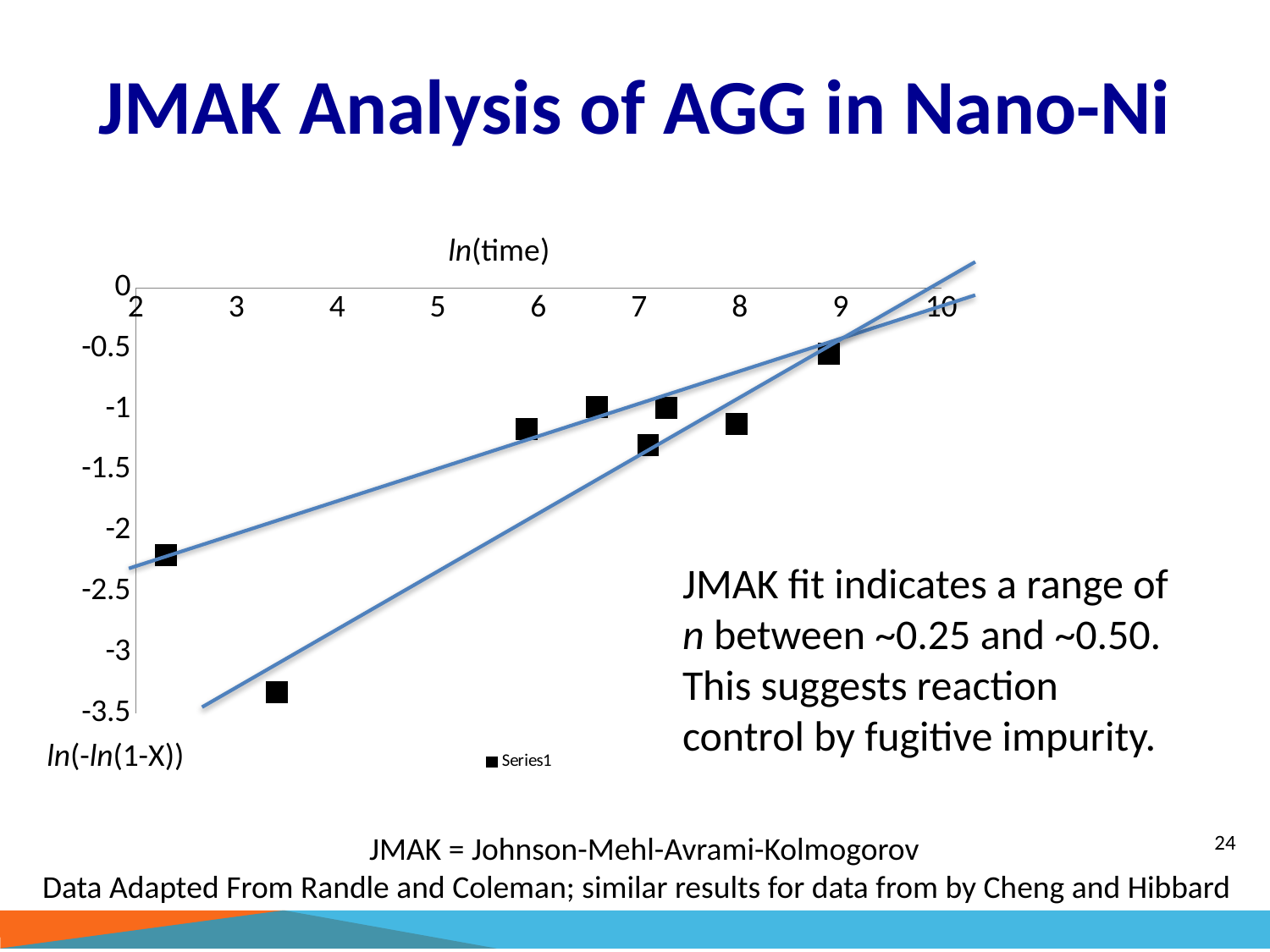
Is the value of the lowest data point (near ln(time) of about 3.4) greater or less than -3? less Which data point has the highest ln(-ln(1-X)) value: the leftmost point or the rightmost point? the rightmost point Is the value of the rightmost data point (near ln(time) of about 9) greater or less than -1? greater How many data points are plotted in the chart? 8 Is the value of the leftmost data point (near ln(time) of about 2.3) greater or less than -2.5? greater Do the plotted values generally rise or fall as ln(time) increases? rise How many series does the chart legend list? 1 What kind of chart is shown on the slide? scatter chart What is the name of the series shown in the chart legend? Series1 What is the lowest value shown on the y axis of the chart? -3.5 What is the label of the x axis of the chart? ln(time)